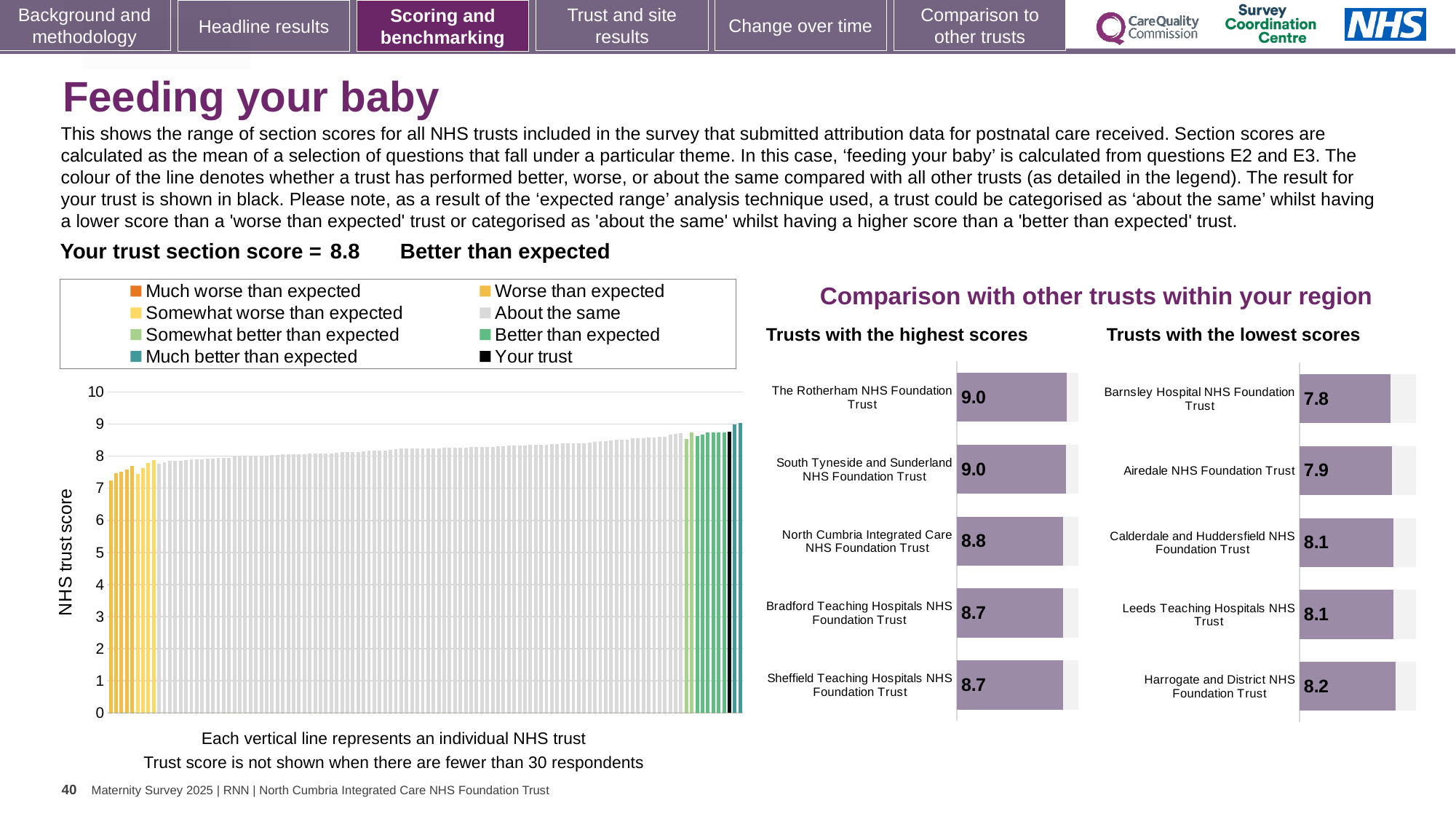
How many entries does the legend of the main 'NHS trust score' chart list? 8 In the 'Trusts with the lowest scores' chart, what is the score for Barnsley Hospital NHS Foundation Trust? 7.8 In the 'Trusts with the highest scores' chart, what is the score for The Rotherham NHS Foundation Trust? 9.0 In the 'Trusts with the lowest scores' chart, which trust has the highest score? Harrogate and District NHS Foundation Trust In the main 'NHS trust score' chart on the left, is the value of the tallest bar greater or less than 8? greater In the 'Trusts with the lowest scores' chart, what is the score for Harrogate and District NHS Foundation Trust? 8.2 In the 'Trusts with the lowest scores' chart, what is the difference between the scores of Harrogate and District NHS Foundation Trust and Barnsley Hospital NHS Foundation Trust? 0.4 In the 'Trusts with the lowest scores' chart, which trust has the lowest score? Barnsley Hospital NHS Foundation Trust How many trusts are shown in the 'Trusts with the highest scores' chart? 5 In the 'Trusts with the lowest scores' chart, which has the larger score: Airedale NHS Foundation Trust or Calderdale and Huddersfield NHS Foundation Trust? Calderdale and Huddersfield NHS Foundation Trust In the 'Trusts with the highest scores' chart, what is the score for Bradford Teaching Hospitals NHS Foundation Trust? 8.7 What kind of chart is the main 'NHS trust score' chart on the left? Bar chart